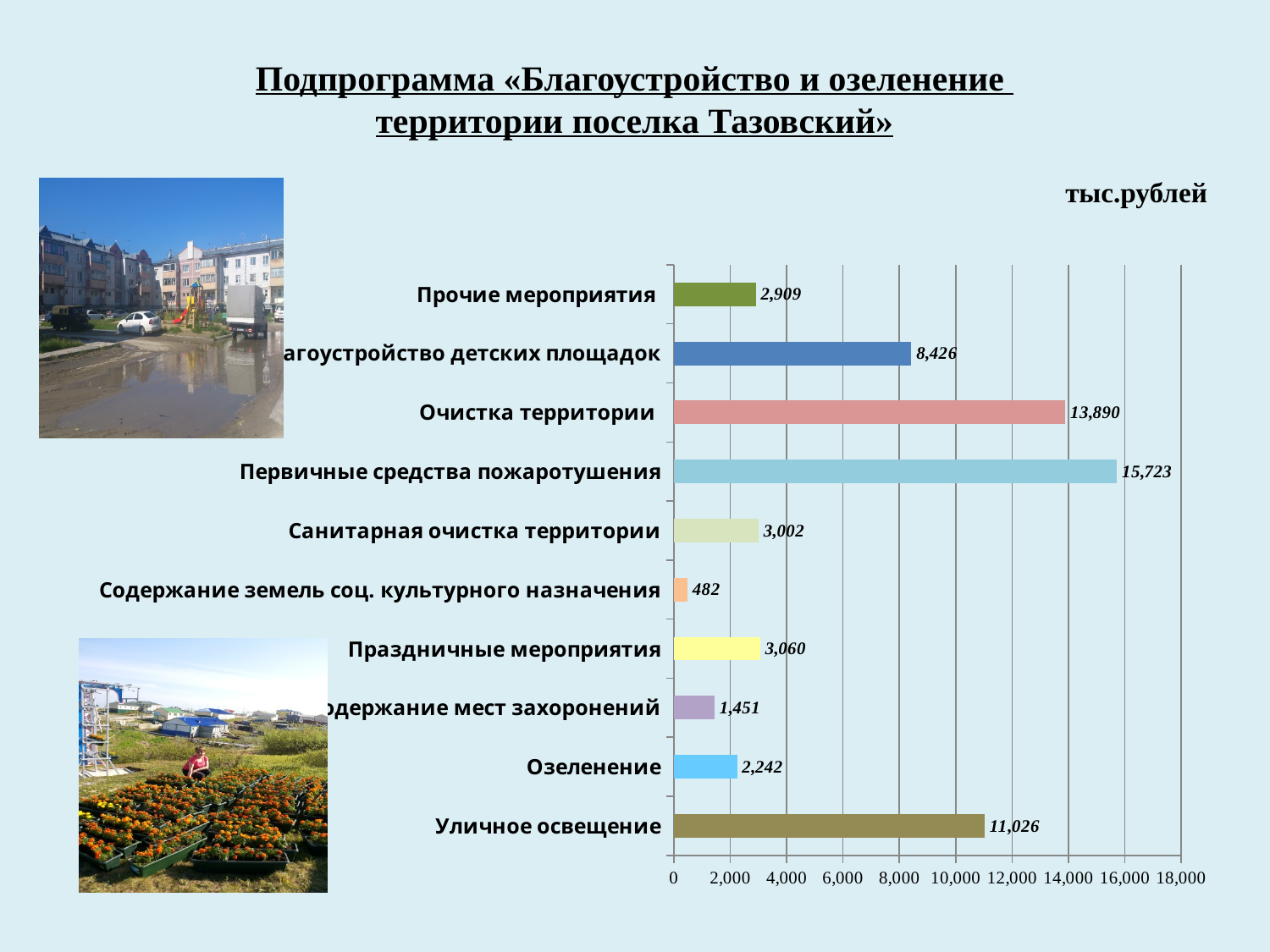
What is the value for Уличное освещение? 11,026 Which category has the lowest value? Содержание земель соц. культурного назначения What type of chart is shown on the slide? Bar chart Which is larger, the value for Прочие мероприятия or the value for Озеленение? Прочие мероприятия What is the value for Содержание земель соц. культурного назначения? 482 What is the value for Озеленение? 2,242 What is the value for Первичные средства пожаротушения? 15,723 What unit is indicated for the values in the chart? тыс.рублей What is the difference between the values for Очистка территории and Уличное освещение? 2,864 Which category has the highest value? Первичные средства пожаротушения Is the value for Уличное освещение greater or less than 10,000? greater How many categories are plotted in the chart? 10